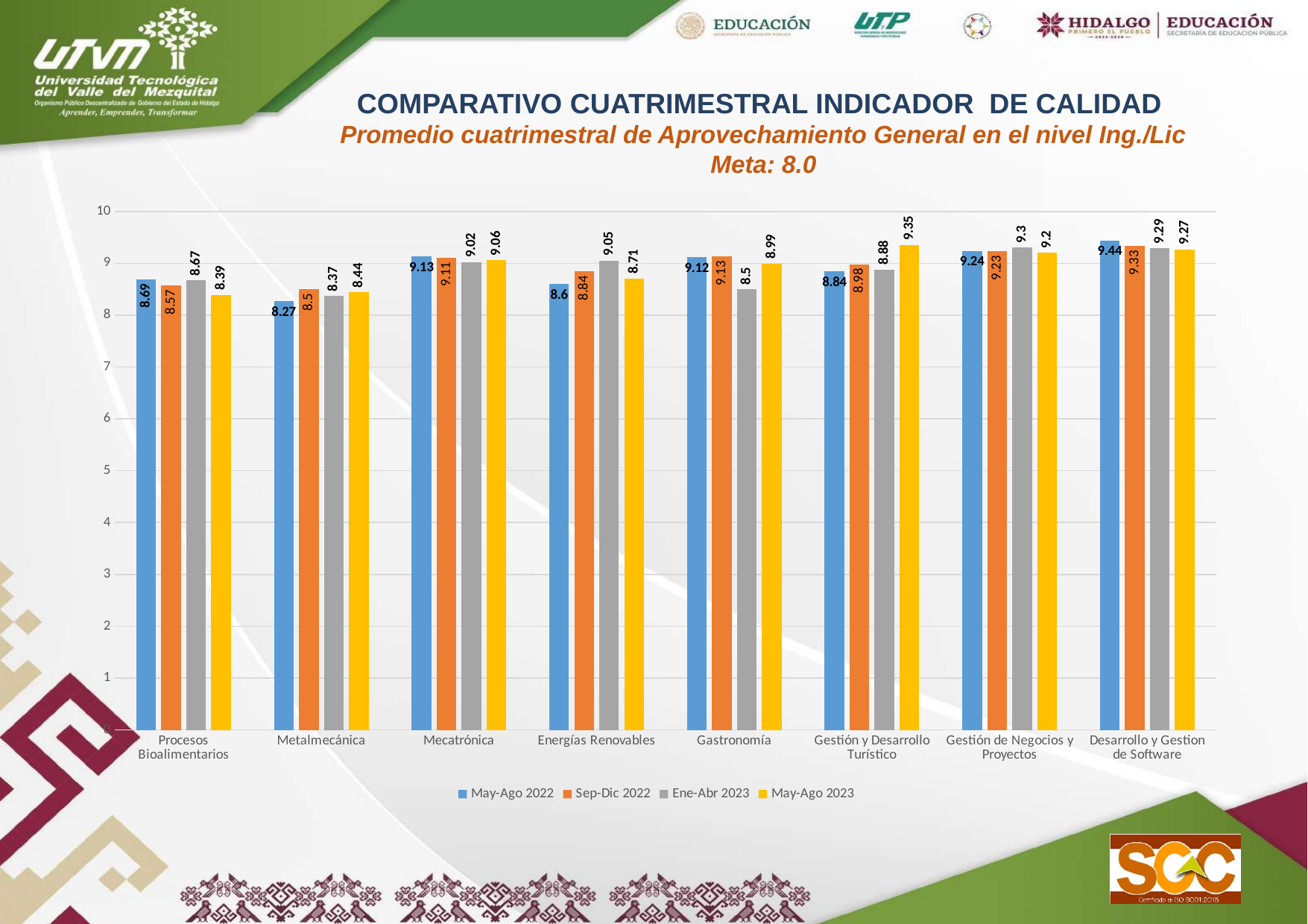
Which category has the highest May-Ago 2022 value? Desarrollo y Gestion de Software How many series does the legend list? 4 What is the May-Ago 2023 value for Gestión y Desarrollo Turístico? 9.35 Which category has the lowest May-Ago 2023 value? Procesos Bioalimentarios What is the Ene-Abr 2023 value for Energías Renovables? 9.05 How many program categories are shown on the x axis? 8 What is the target (Meta) stated in the chart title? 8.0 What is the Sep-Dic 2022 value for Metalmecánica? 8.5 Is the May-Ago 2022 value for Metalmecánica greater or less than 8? greater What type of chart is shown on the slide? bar chart For Gastronomía, which is larger: the Ene-Abr 2023 value or the May-Ago 2023 value? May-Ago 2023 What is the difference between the May-Ago 2023 and May-Ago 2022 values for Gestión y Desarrollo Turístico? 0.51